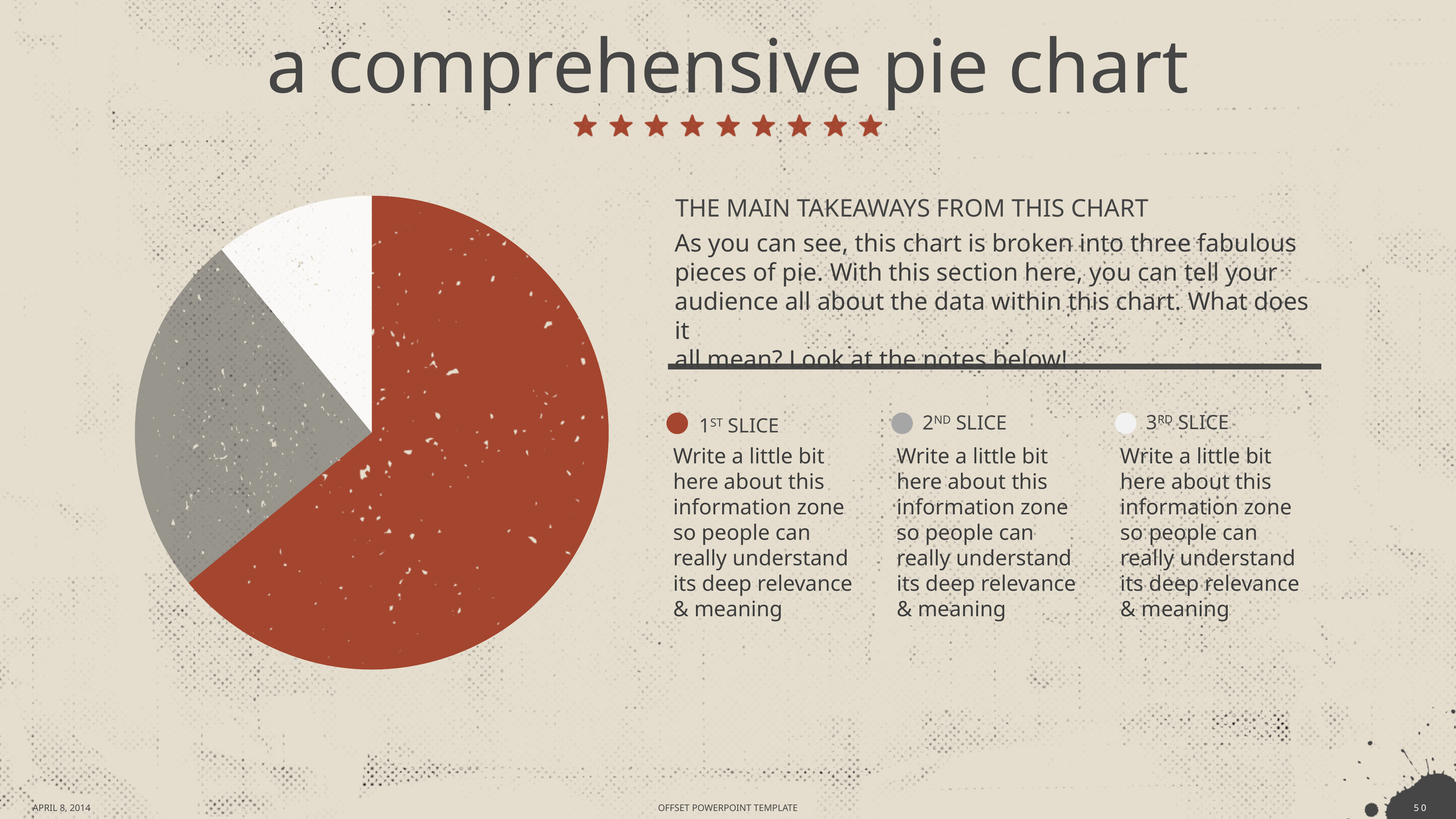
Which slice of the pie chart is the largest? 1st slice Which is larger in the pie chart, the 1st slice or the 2nd slice? 1st slice What colour is the 2nd slice in the pie chart? grey Which slice of the pie chart is the smallest? 3rd slice Does the 1st slice take up more or less than half of the pie chart? more How many entries does the legend of the pie chart list? 3 What is the title of the slide containing the pie chart? a comprehensive pie chart What kind of chart is shown on the slide? pie chart How many slices does the pie chart have? 3 Which is larger in the pie chart, the 2nd slice or the 3rd slice? 2nd slice